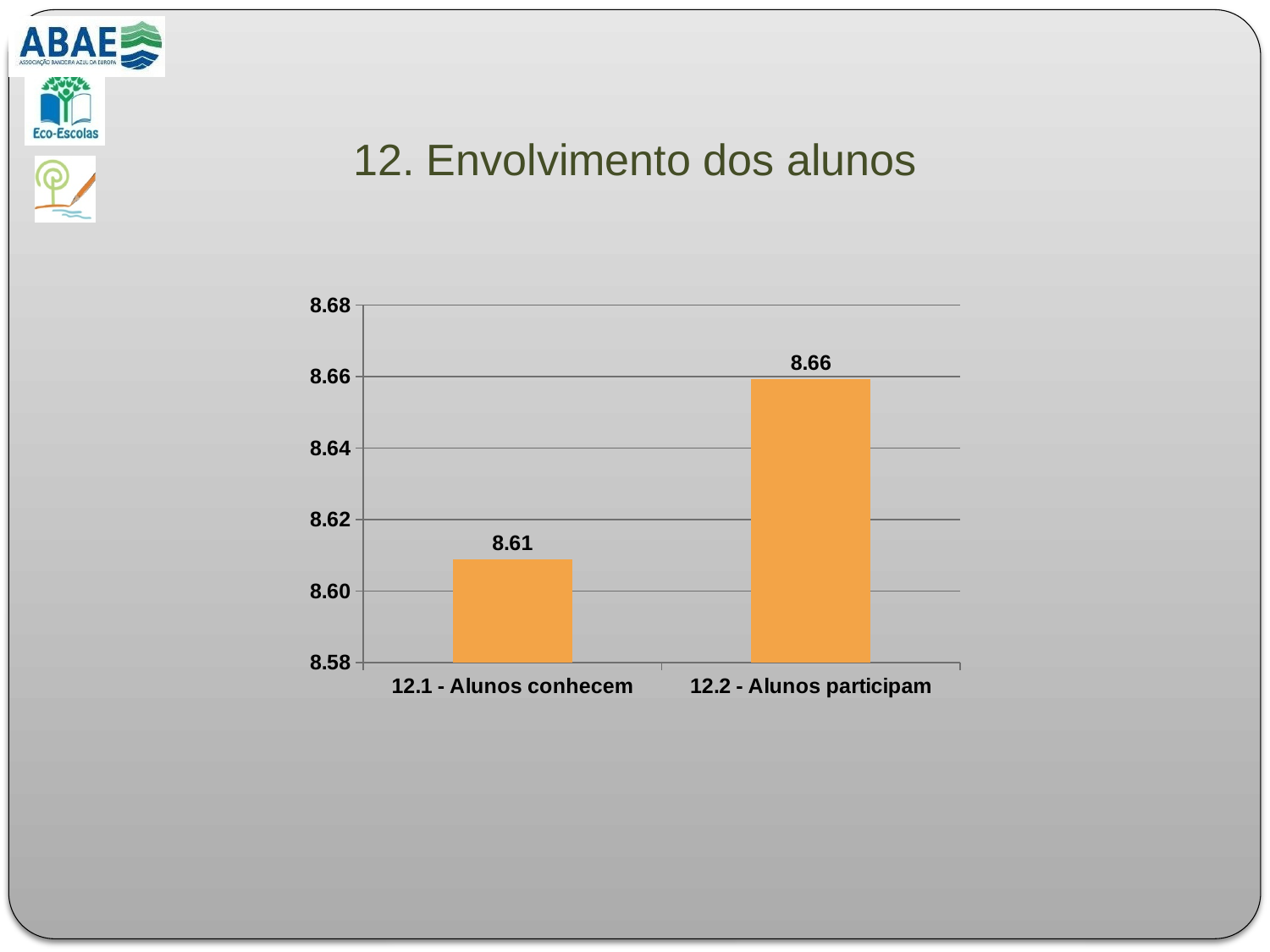
Which is larger, the value for 12.1 - Alunos conhecem or the value for 12.2 - Alunos participam? 12.2 - Alunos participam What kind of chart is shown on the slide? bar chart What is the title of the slide containing the chart? 12. Envolvimento dos alunos What is the value for 12.1 - Alunos conhecem? 8.61 Which category has the lowest value? 12.1 - Alunos conhecem Which category has the highest value? 12.2 - Alunos participam Do the values rise or fall from the first category to the second? rise How many categories are shown in the chart? 2 Is the value for 12.1 - Alunos conhecem greater or less than 8.62? less Is the value for 12.2 - Alunos participam greater or less than 8.64? greater What is the value for 12.2 - Alunos participam? 8.66 What is the difference between the values for 12.2 - Alunos participam and 12.1 - Alunos conhecem? 0.05